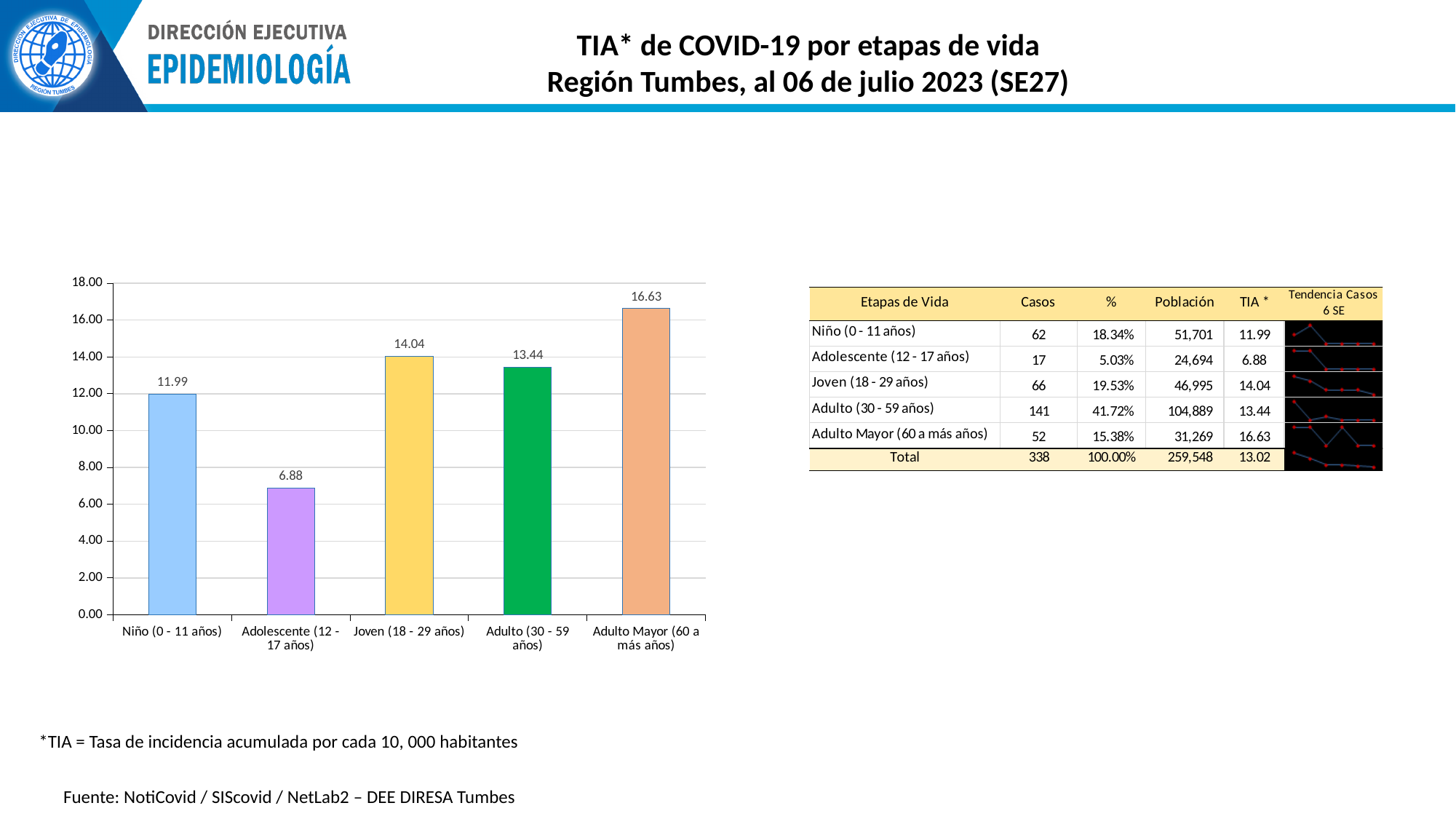
What is the TIA value shown for Niño (0 - 11 años) in the bar chart? 11.99 How many life-stage categories are plotted in the bar chart? 5 What is the TIA value shown for Joven (18 - 29 años) in the bar chart? 14.04 Which life stage has the highest bar in the chart? Adulto Mayor (60 a más años) Is the value for Adulto (30 - 59 años) greater or less than 12.00? greater Which has a higher TIA value in the chart, Joven (18 - 29 años) or Adulto (30 - 59 años)? Joven (18 - 29 años) What is the difference between the TIA values for Adulto Mayor (60 a más años) and Adolescente (12 - 17 años)? 9.75 What is the TIA value shown for Adolescente (12 - 17 años) in the bar chart? 6.88 Which life stage has the lowest bar in the chart? Adolescente (12 - 17 años) What is the difference between the TIA values for Joven (18 - 29 años) and Adulto (30 - 59 años)? 0.60 What is the maximum value shown on the vertical axis of the bar chart? 18.00 What kind of chart is used to show the TIA by life stage? Bar chart